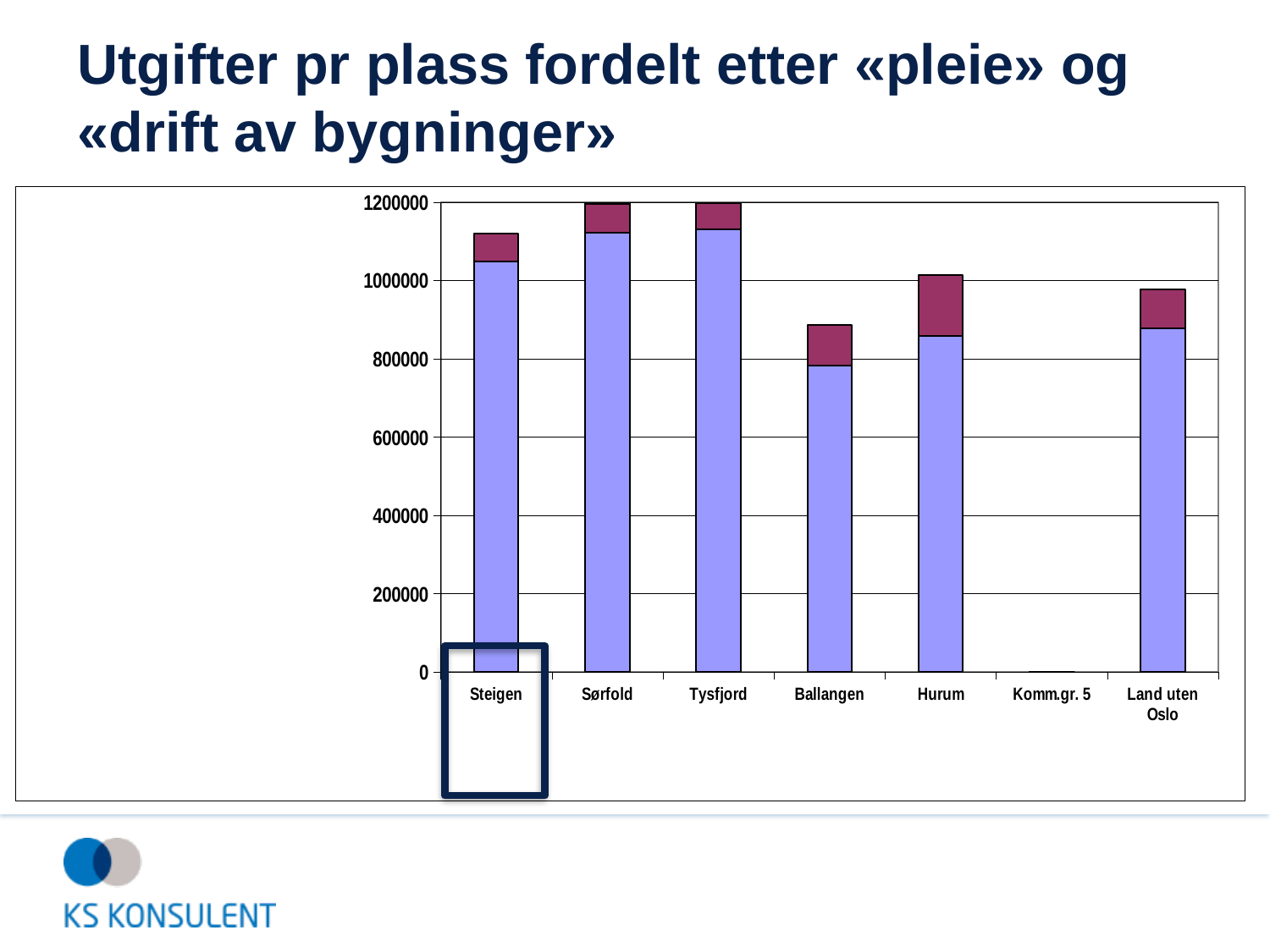
Is the total value for Ballangen greater or less than 1000000? less Is the total value for Sørfold greater or less than 1000000? greater Is the total value for Ballangen greater or less than 800000? greater Which has the larger total value, Hurum or Ballangen? Hurum Which has the larger total value, Steigen or Ballangen? Steigen What is the title of the slide containing the chart? Utgifter pr plass fordelt etter «pleie» og «drift av bygninger» Which has the larger total value, Sørfold or Land uten Oslo? Sørfold Which category has the lowest total value in the chart? Komm.gr. 5 How many categories are shown on the x axis of the chart? 7 What kind of chart is shown on the slide? Stacked bar chart